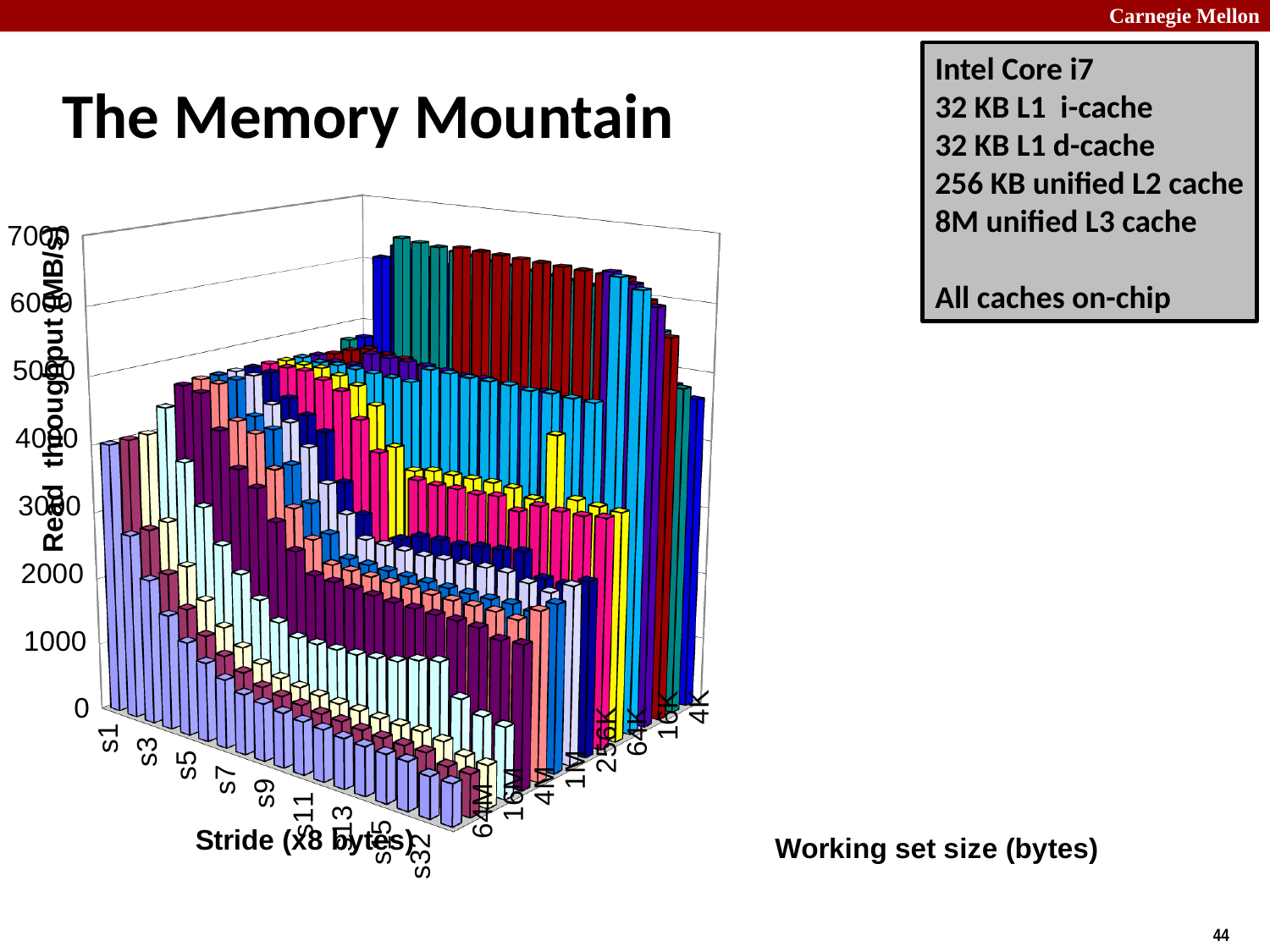
At a working set size of 64M, does read throughput rise or fall as the stride increases from s1 to s32? fall What kind of chart is shown on the slide? bar chart What is the label of the vertical axis of the chart? Read throughput (MB/s) Is the read throughput for stride s1 at a working set size of 64M greater or less than 2000? greater For stride s1, does read throughput rise or fall as the working set size decreases from 64M to 4K? rise At a working set size of 64M, which stride has the higher read throughput, s1 or s32? s1 What is the title of the chart? The Memory Mountain Is the read throughput for stride s1 at a working set size of 4K greater or less than 5000? less Is the read throughput for stride s32 at a working set size of 64M greater or less than 1000? less